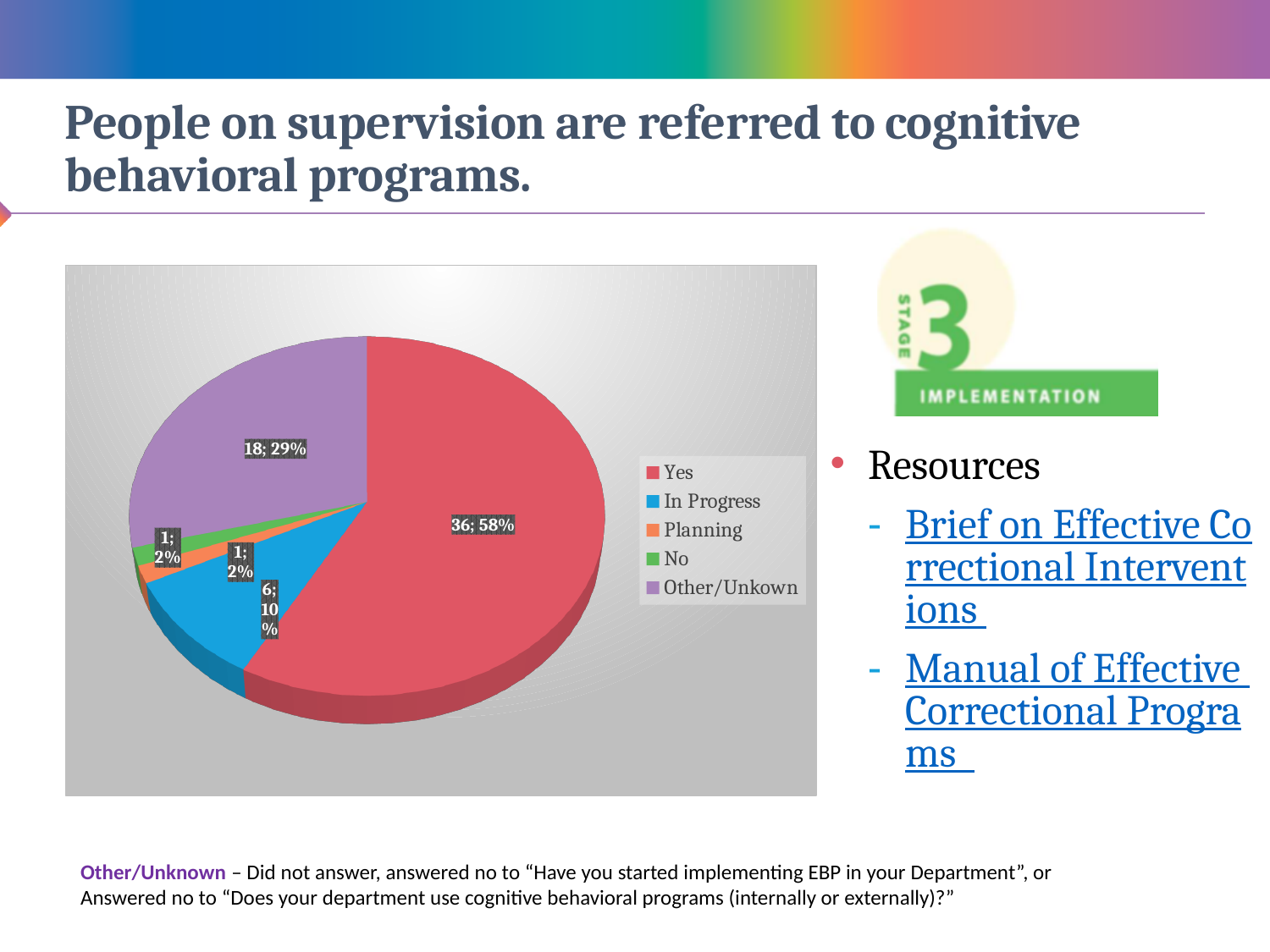
What is the count and percentage shown for the Yes slice? 36; 58% Which legend entry is shown in purple? Other/Unkown What is the difference in count between the Yes slice and the Other/Unknown slice? 18 What is the count and percentage shown for the Other/Unknown slice? 18; 29% What colour is the Yes slice in the pie chart? red What is the difference in percentage between the Yes slice and the In Progress slice? 48% What kind of chart is shown on the slide? pie chart What share of the pie does the Planning slice represent? 2% Which category has the largest slice of the pie? Yes Which category has the larger slice, In Progress or Other/Unknown? Other/Unknown How many categories does the pie chart's legend list? 5 What is the count and percentage shown for the In Progress slice? 6; 10%